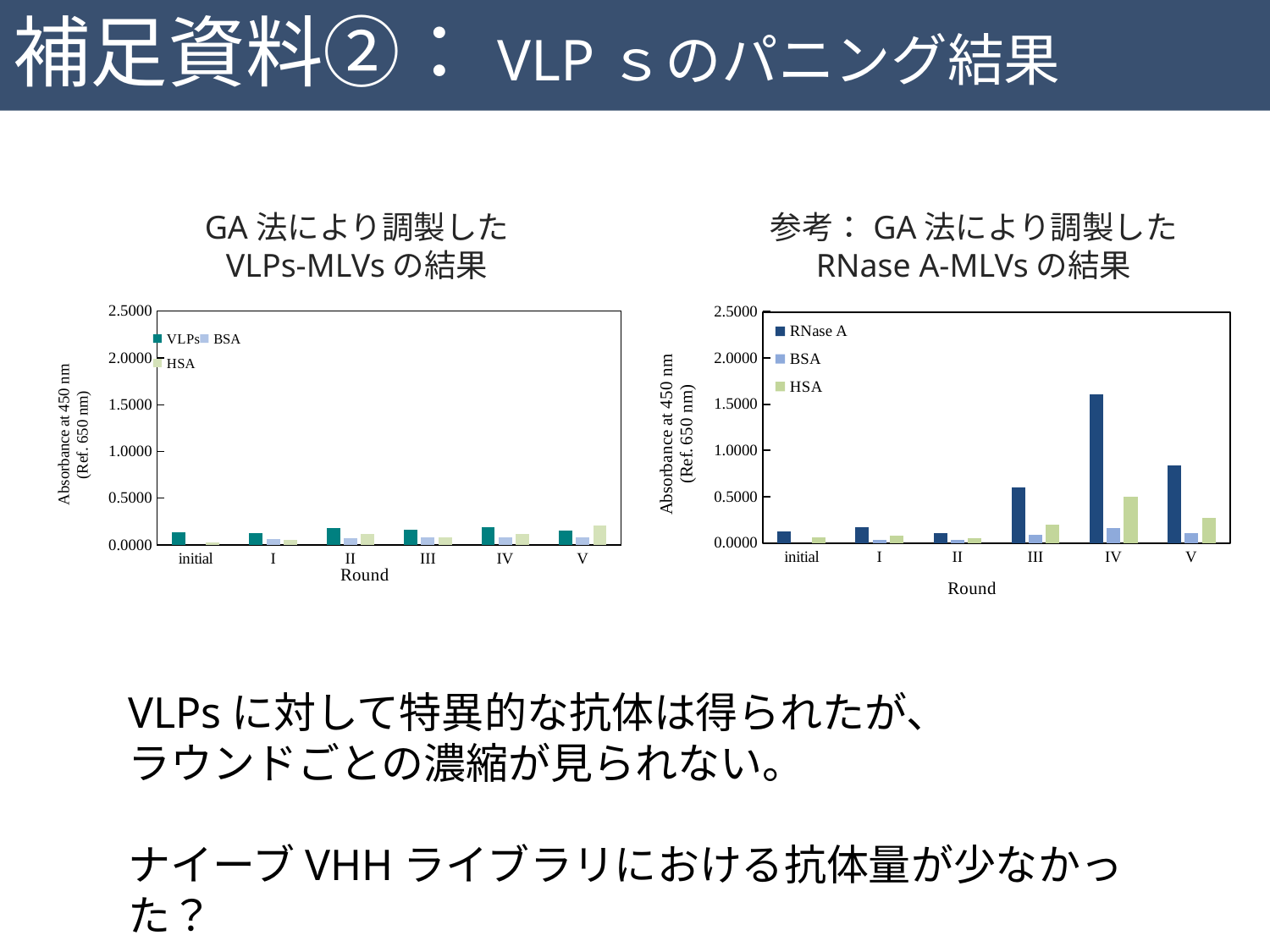
In the right chart (RNase A-MLVs の結果), which is larger: the RNase A value at round III or the BSA value at round III? RNase A What kind of chart is the left chart (VLPs-MLVs の結果)? bar chart What is the y-axis label of the left chart (VLPs-MLVs の結果)? Absorbance at 450 nm (Ref. 650 nm) In the left chart (VLPs-MLVs の結果), is the VLPs value at round II greater or less than 0.5000? less In the right chart (RNase A-MLVs の結果), at which round is the RNase A value highest? IV In the right chart (RNase A-MLVs の結果), which is larger: the RNase A value at round IV or at round V? round IV Which series are listed in the legend of the left chart (VLPs-MLVs の結果)? VLPs, BSA, HSA In the right chart (RNase A-MLVs の結果), is the RNase A value at round V greater or less than 1.0000? less How many rounds (categories) are shown on the x axis of the left chart (VLPs-MLVs の結果)? 6 In the right chart (RNase A-MLVs の結果), is the RNase A value at round V greater or less than 0.5000? greater How many series does the legend of the right chart (RNase A-MLVs の結果) list? 3